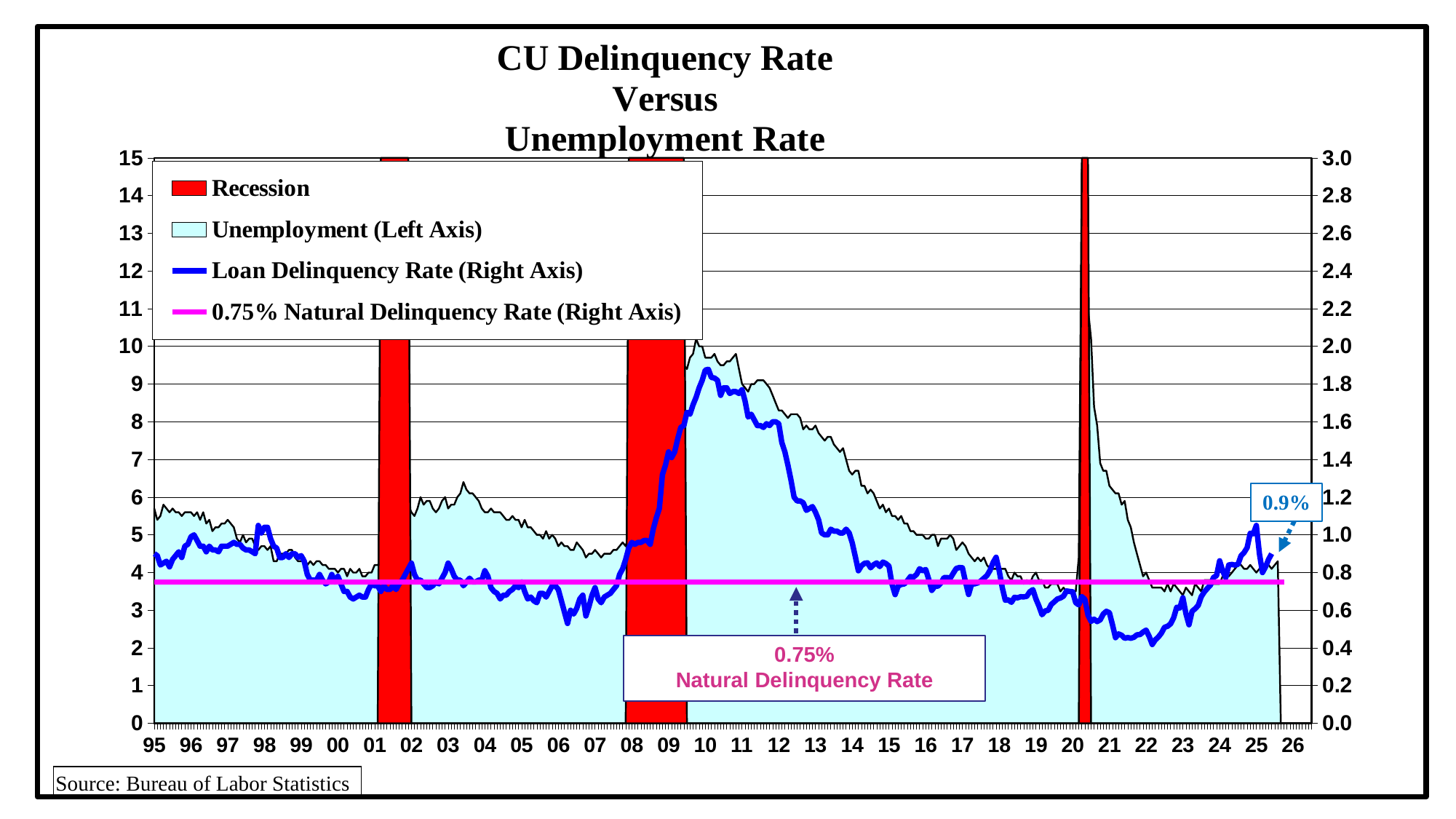
Which is larger, the Loan Delinquency Rate in 2010 or in 2022? 2010 How many entries does the chart legend list? 4 In which year on the x axis does the unemployment rate reach its highest point? 20 What is the most recent Loan Delinquency Rate value labelled on the chart? 0.9% What value is the Natural Delinquency Rate line set at? 0.75% Is the peak unemployment rate around 2010 greater or less than 8 on the left axis? greater What is the title of the chart? CU Delinquency Rate Versus Unemployment Rate Is the Loan Delinquency Rate in 2022 greater or less than 0.6 on the right axis? less Does the Loan Delinquency Rate rise or fall between 2010 and 2014? fall Is the Loan Delinquency Rate series drawn as a line or as bars? a line In which year on the x axis does the Loan Delinquency Rate reach its lowest point? 22 How many recession periods are shaded on the chart? 3